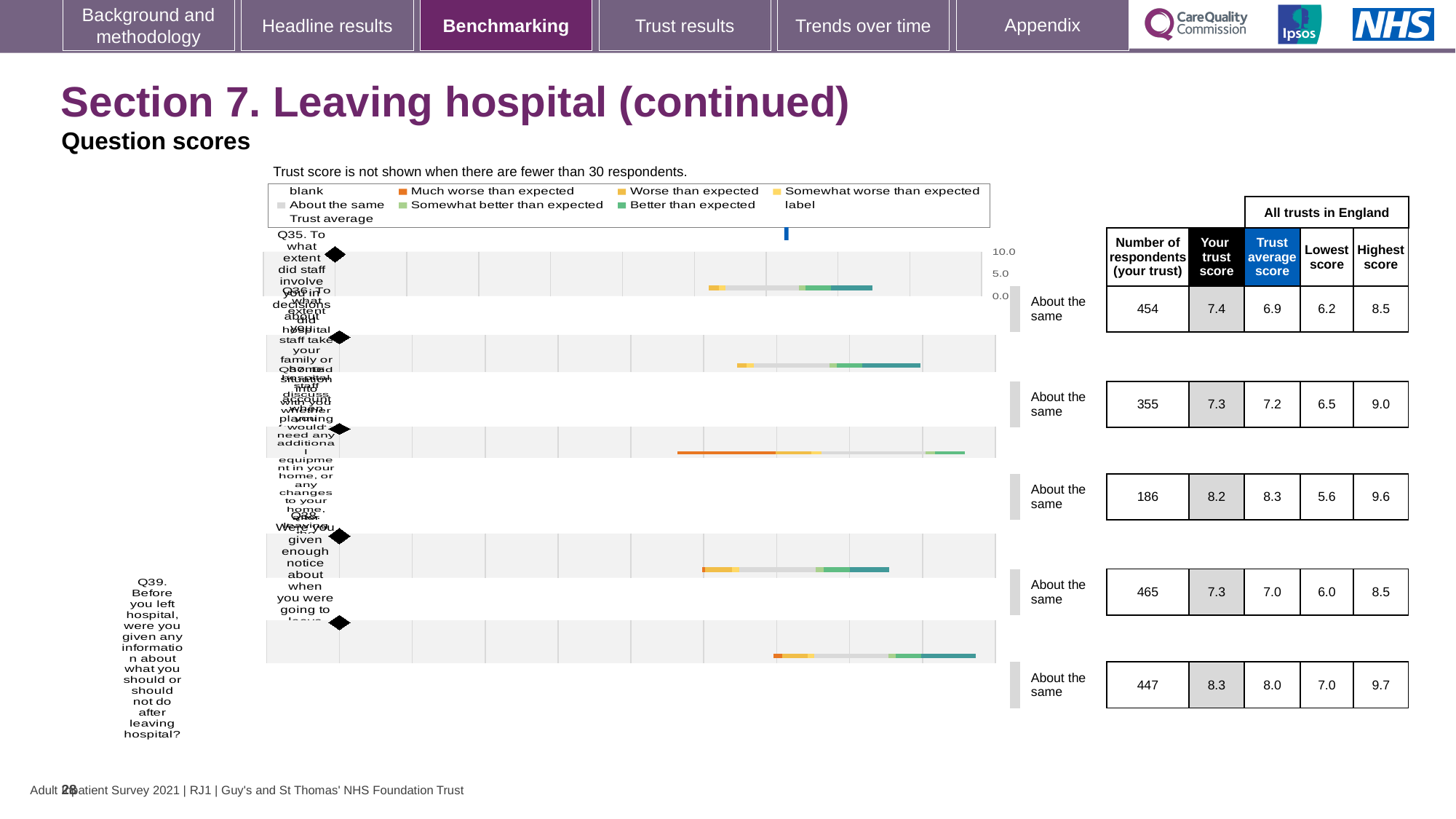
How many questions are plotted on the chart? 5 For Q35, how much higher is the 'Your trust score' than the trust average score? 0.5 What benchmark category is shown for Q38 about being given enough notice about leaving hospital? About the same How many respondents (your trust) are shown for Q35 about staff involving you in decisions about leaving hospital? 454 Which question has the fewest respondents for your trust? Q37 Which question has the most respondents for your trust? Q38 What kind of chart is used to show the question scores? Bar chart What is the highest score across all trusts in England for Q39? 9.7 What is the lowest score across all trusts in England for Q37? 5.6 What is the trust average score for Q37 about staff discussing additional equipment or changes to your home? 8.3 For Q36, which is larger: the 'Your trust score' or the trust average score? Your trust score What is the 'Your trust score' for Q39 about being given information on what you should or should not do after leaving hospital? 8.3